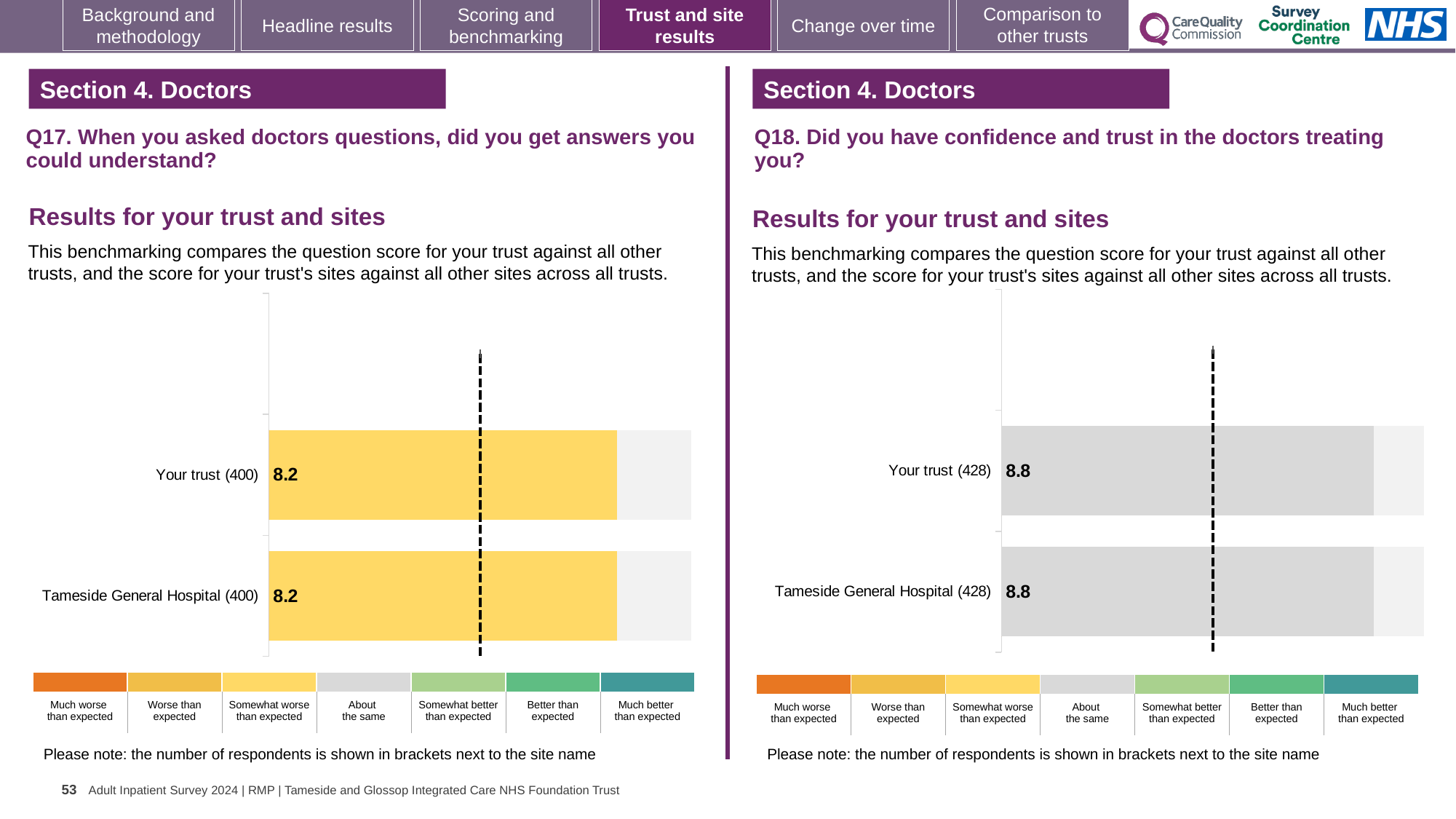
What kind of chart is used on the Q18 chart (right)? Bar chart On the Q17 chart (left), what is the score for Tameside General Hospital? 8.2 On the Q18 chart (right), what is the difference between the score for Your trust and the score for Tameside General Hospital? 0 On the Q18 chart (right), what is the score for Tameside General Hospital? 8.8 On the Q18 chart (right), what is the score for Your trust? 8.8 On the Q17 chart (left), what is the difference between the score for Your trust and the score for Tameside General Hospital? 0 On the Q17 chart (left), what is the score for Your trust? 8.2 How many bars are plotted on the Q18 chart (right)? 2 How many bars are plotted on the Q17 chart (left)? 2 According to the colour key, which benchmark category do the bars on the Q18 chart (right) fall into? About the same How many respondents are shown in brackets for Tameside General Hospital on the Q18 chart (right)? 428 How many respondents are shown in brackets for Your trust on the Q17 chart (left)? 400